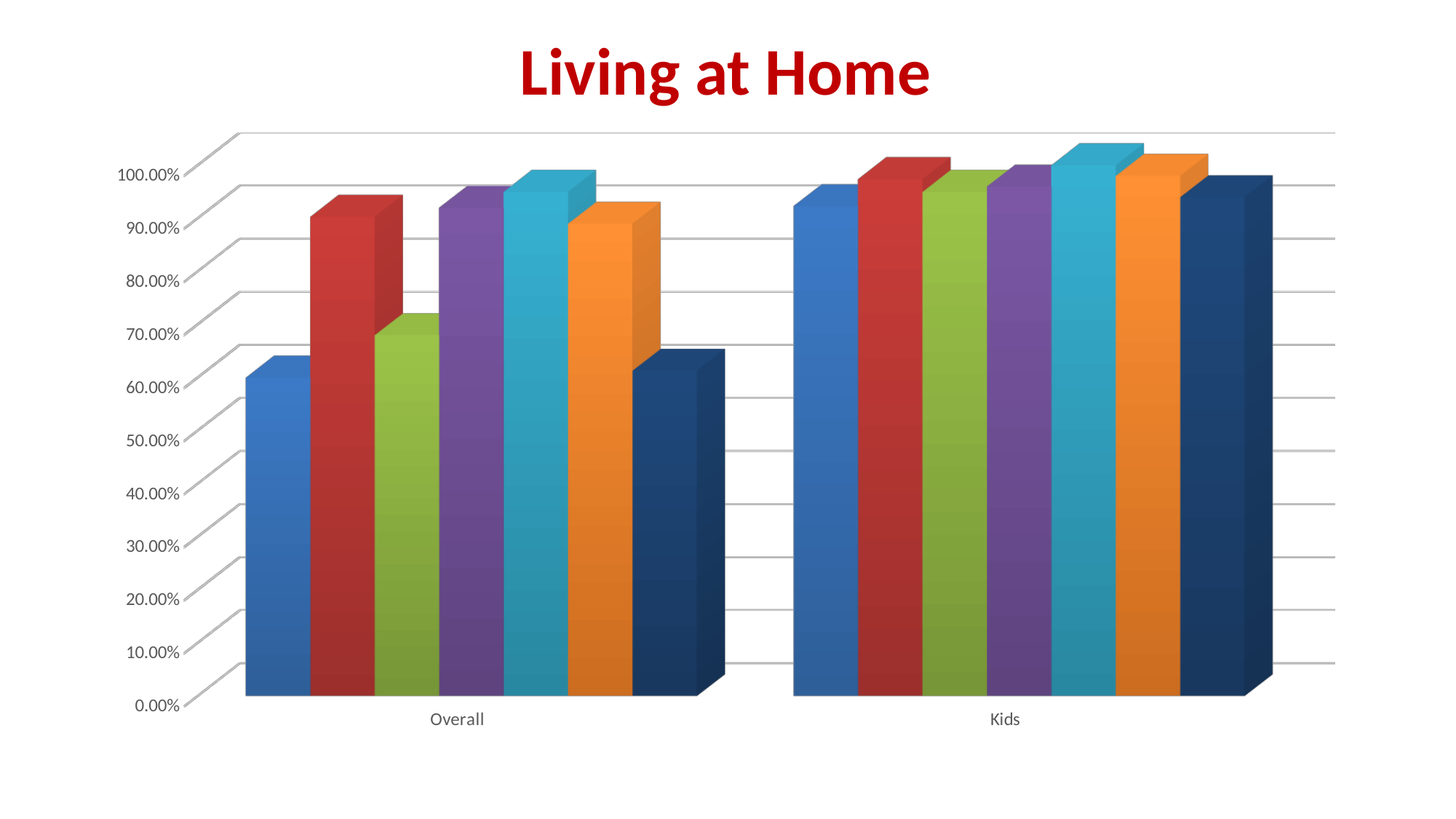
In the Overall category, which is larger, the red bar or the green bar? the red bar Which bar is the tallest in the Overall category? the cyan bar Which is larger, the blue bar for Overall or the blue bar for Kids? the blue bar for Kids Is the value of the blue bar for Kids greater or less than 80.00%? greater Is the value of the blue bar for Overall greater or less than 70.00%? less Do the values rise or fall from Overall to Kids? rise Is the value of the green bar for Overall greater or less than 80.00%? less How many bars are plotted for the Overall category? 7 How many categories are shown on the x axis? 2 What is the title of the chart? Living at Home What kind of chart is shown on the slide? bar chart